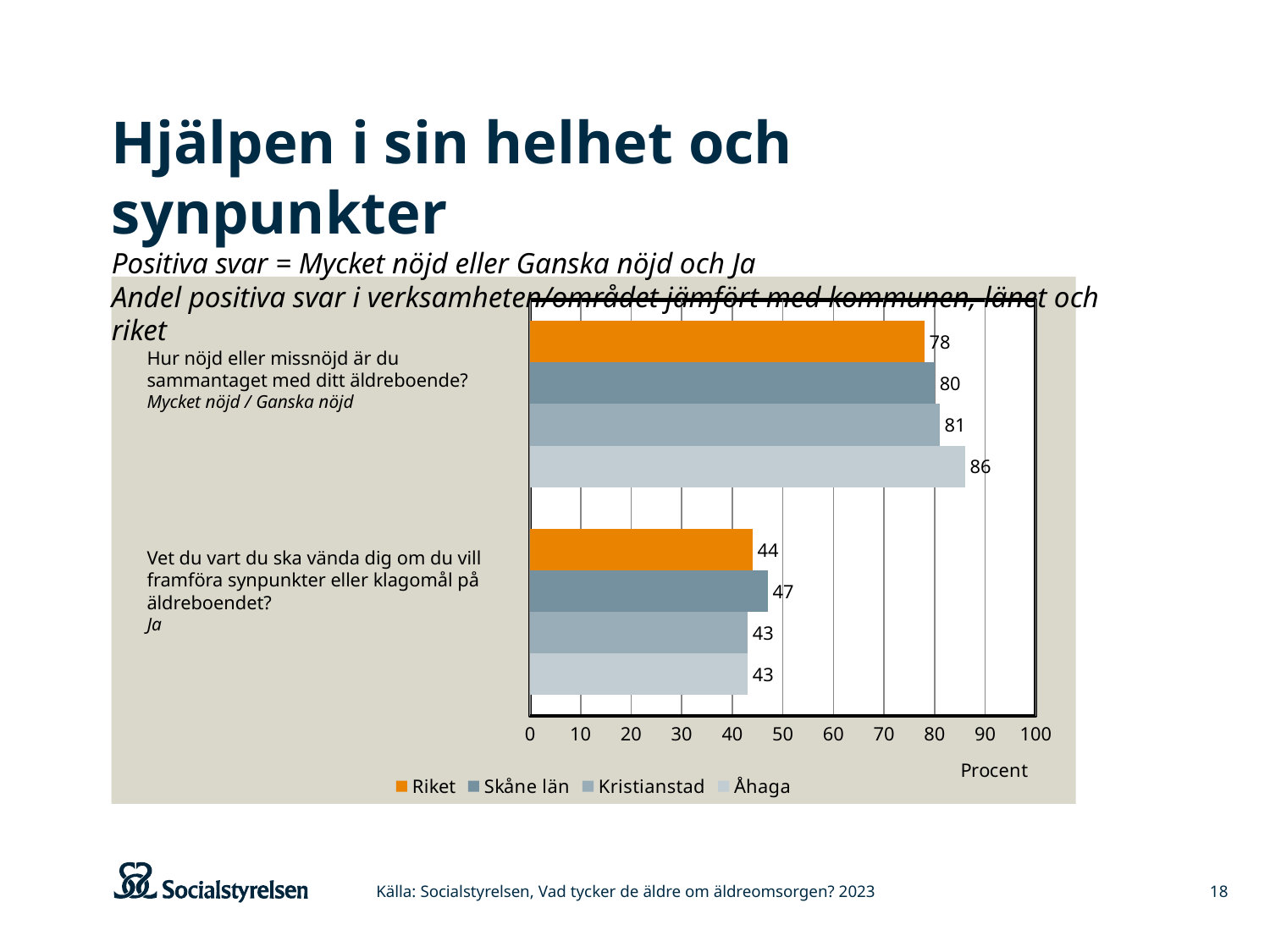
Which series has the highest value on the question about overall satisfaction with the elderly home? Åhaga What is the difference between Åhaga and Riket on the question about overall satisfaction with the elderly home? 8 What is the value for Åhaga on the question about overall satisfaction with the elderly home (Hur nöjd eller missnöjd är du sammantaget med ditt äldreboende?)? 86 Which series has the lowest value on the question about overall satisfaction with the elderly home? Riket What is the value for Kristianstad on the question about knowing where to turn with complaints? 43 Which is larger: Skåne län or Riket on the question about knowing where to turn with complaints? Skåne län How many series does the legend list? 4 What is the value for Skåne län on the question about knowing where to turn with complaints (Vet du vart du ska vända dig...)? 47 Which series has the highest value on the question about knowing where to turn with complaints? Skåne län What label is shown on the horizontal axis of the chart? Procent What kind of chart is shown on the slide? bar chart What is the value for Riket on the question about overall satisfaction with the elderly home? 78